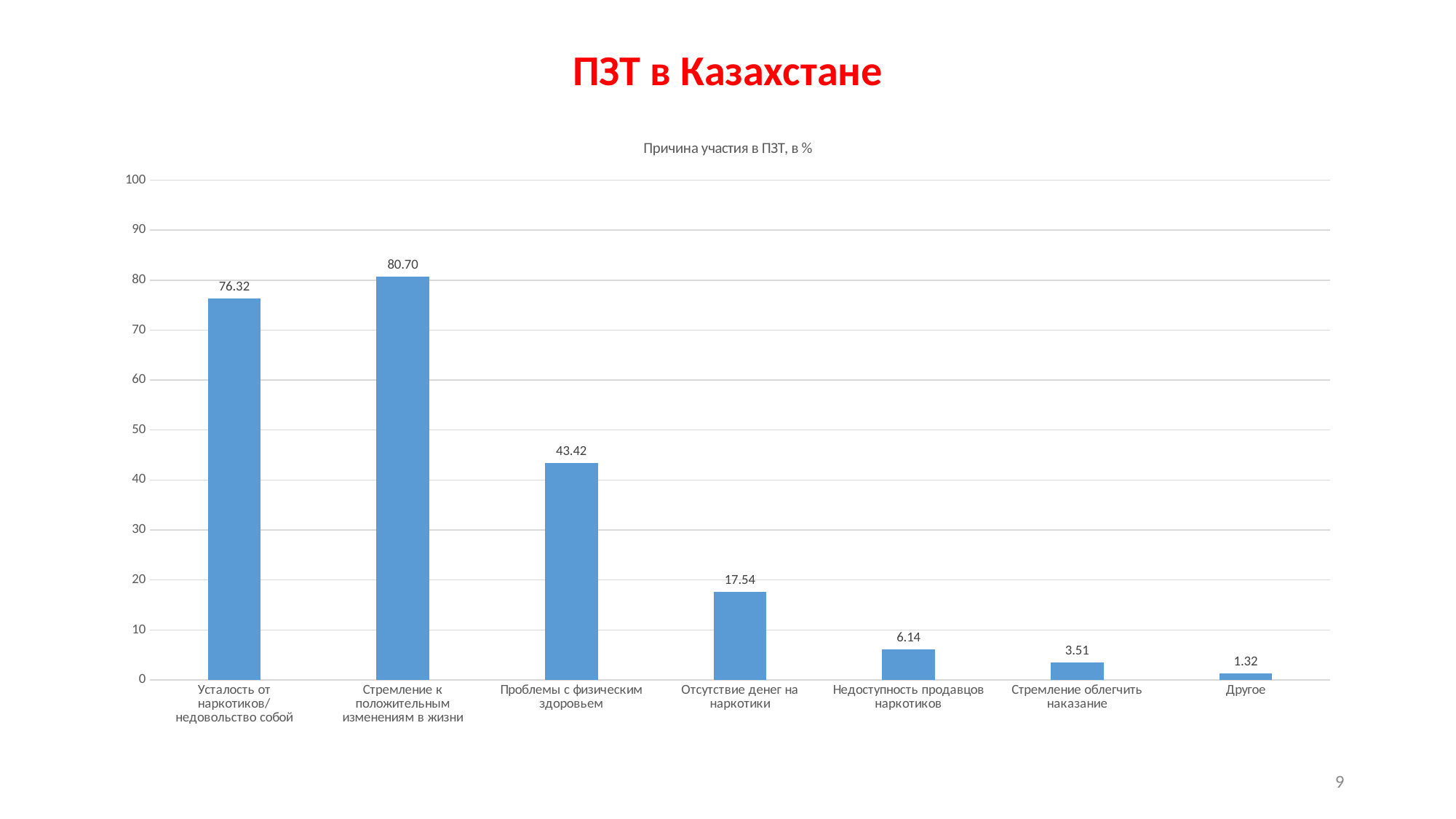
Which category has the lowest value? Другое How many categories are shown in the chart? 7 What is the value for «Недоступность продавцов наркотиков»? 6.14 What kind of chart is shown on the slide? bar chart What is the title of the chart? Причина участия в ПЗТ, в % What is the value for «Другое»? 1.32 What is the value for «Усталость от наркотиков/недовольство собой»? 76.32 What is the difference between «Стремление к положительным изменениям в жизни» and «Усталость от наркотиков/недовольство собой»? 4.38 Which category has the highest value? Стремление к положительным изменениям в жизни Is the value for «Проблемы с физическим здоровьем» greater or less than 50? less What is the value for «Проблемы с физическим здоровьем»? 43.42 Which is larger: «Отсутствие денег на наркотики» or «Стремление облегчить наказание»? Отсутствие денег на наркотики